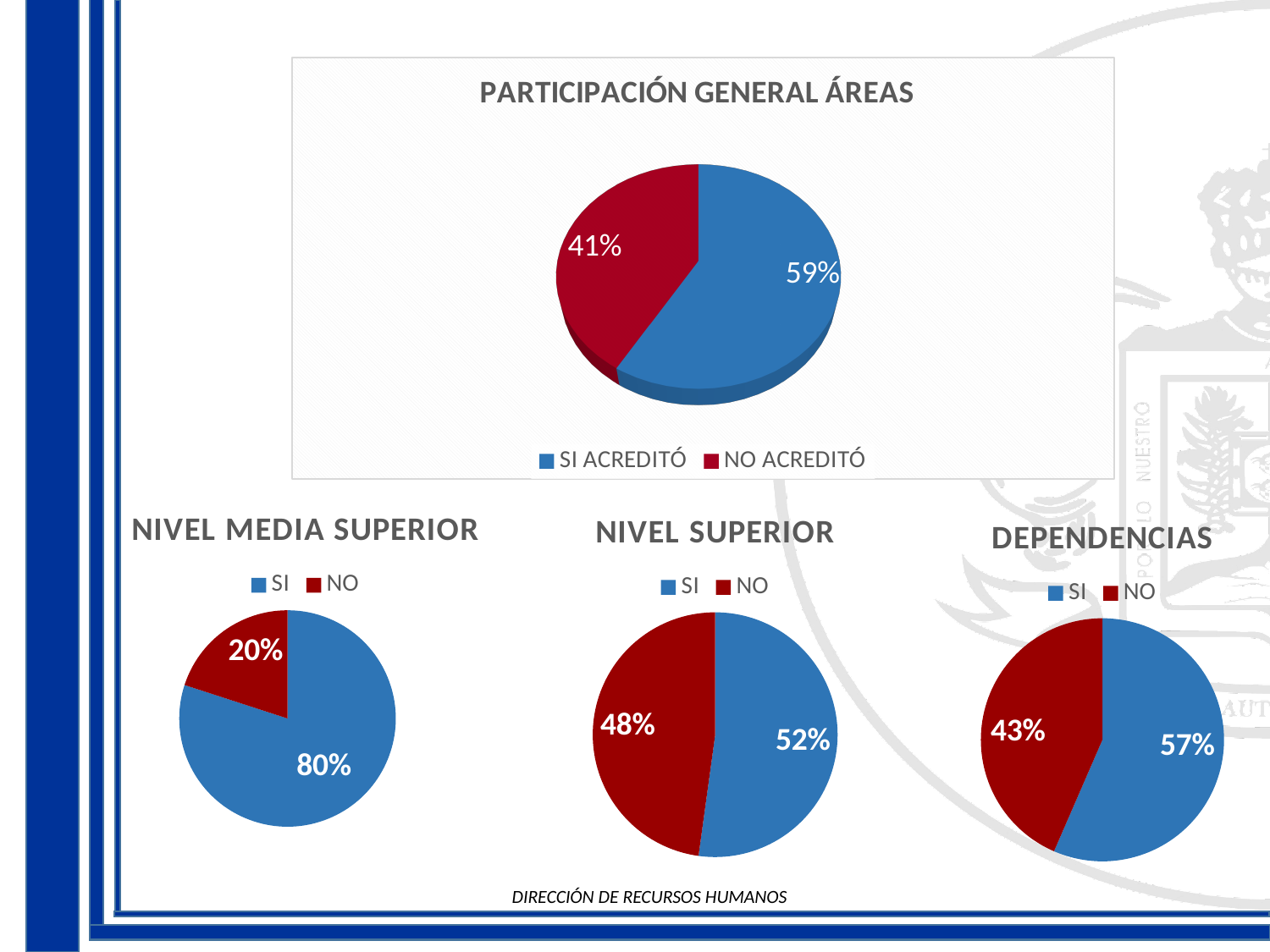
In the PARTICIPACIÓN GENERAL ÁREAS chart, what share is SI ACREDITÓ? 59% In the DEPENDENCIAS chart, what is the value for SI? 57% In the NIVEL MEDIA SUPERIOR chart, what is the difference between SI and NO? 60% What are the legend entries of the PARTICIPACIÓN GENERAL ÁREAS chart? SI ACREDITÓ, NO ACREDITÓ In the NIVEL MEDIA SUPERIOR chart, what is the value for SI? 80% In the NIVEL SUPERIOR chart, which is larger, SI or NO? SI In the PARTICIPACIÓN GENERAL ÁREAS chart, what share is NO ACREDITÓ? 41% How many slices does the NIVEL SUPERIOR chart have? 2 In the NIVEL MEDIA SUPERIOR chart, what is the value for NO? 20% What kind of chart is the PARTICIPACIÓN GENERAL ÁREAS chart? Pie chart In the DEPENDENCIAS chart, what is the difference between SI and NO? 14% In the NIVEL SUPERIOR chart, what is the value for NO? 48%